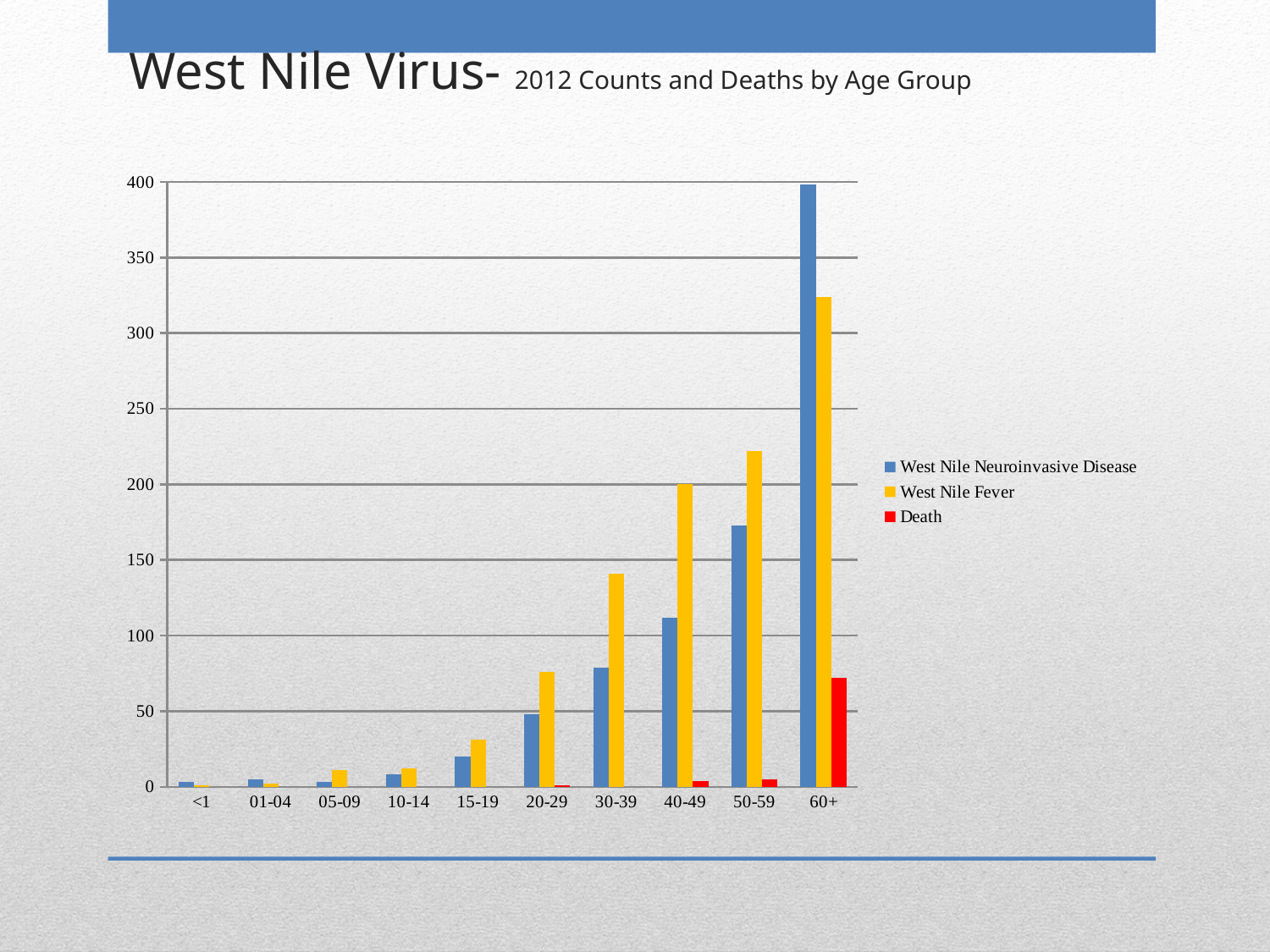
How many age groups are shown on the x axis? 10 Which age group has the highest West Nile Neuroinvasive Disease count? 60+ Which age group has the highest number of deaths? 60+ For the 40-49 age group, which is larger: West Nile Fever or West Nile Neuroinvasive Disease? West Nile Fever Is the West Nile Neuroinvasive Disease value for the 60+ age group greater or less than 350? greater What kind of chart is shown on the slide? bar chart Which age group has the highest West Nile Fever count? 60+ How many series does the legend list? 3 Is the West Nile Fever value for the 60+ age group greater or less than 350? less Is the Death value for the 60+ age group greater or less than 50? greater Do the West Nile Fever values generally rise or fall as age group increases along the x axis? rise